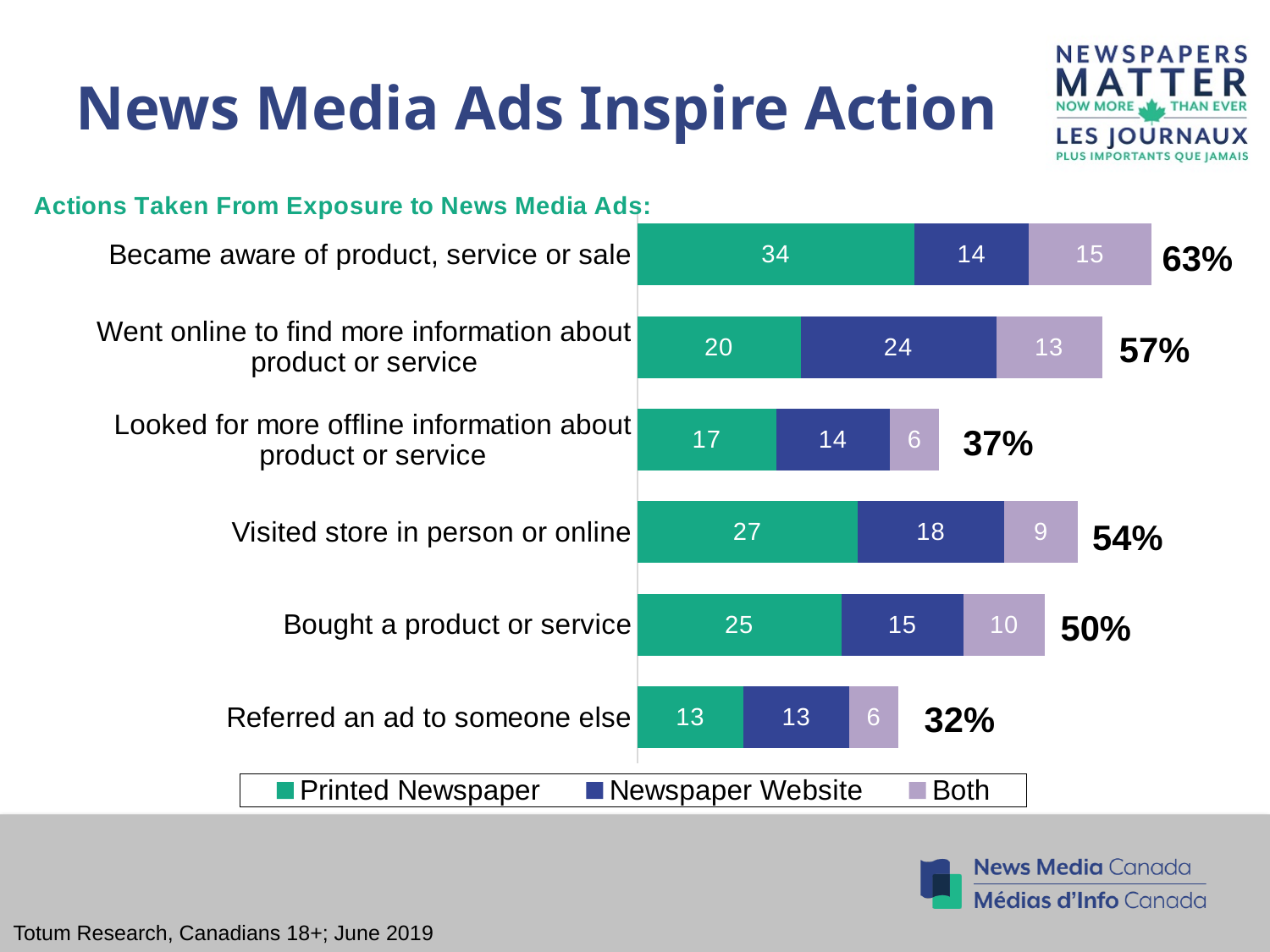
What is the Printed Newspaper value for "Became aware of product, service or sale"? 34 How many actions (categories) are shown in the chart? 6 Which series is shown in green in the legend? Printed Newspaper For "Went online to find more information about product or service", which is larger: the Printed Newspaper value or the Newspaper Website value? Newspaper Website What kind of chart is shown on the slide? Stacked bar chart What is the Newspaper Website value for "Went online to find more information about product or service"? 24 What is the total shown for the "Visited store in person or online" bar? 54% How many series does the legend list? 3 Which action has the highest total percentage? Became aware of product, service or sale What is the Both value for "Bought a product or service"? 10 Which action has the lowest total percentage? Referred an ad to someone else What is the difference between the Printed Newspaper values for "Became aware of product, service or sale" and "Referred an ad to someone else"? 21